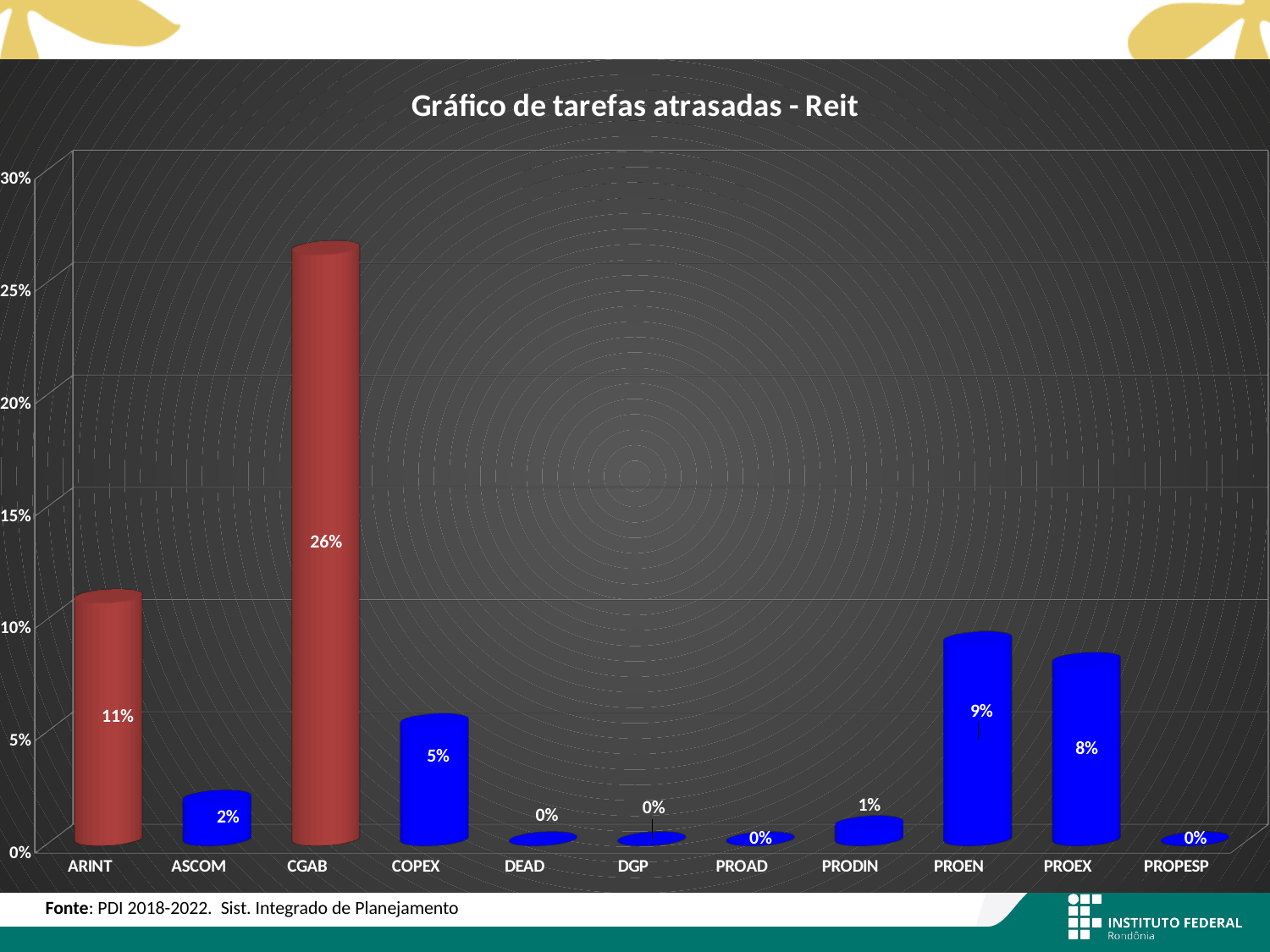
Which is larger, the value for COPEX or the value for ASCOM? COPEX What is the value for ARINT? 11% How many categories have a value of 0%? 4 What is the title of the chart? Gráfico de tarefas atrasadas - Reit Which category has the highest value? CGAB How many categories are shown on the x axis? 11 What is the value for PRODIN? 1% Is the value for CGAB greater or less than 25%? greater What is the value for CGAB? 26% What is the value for PROEN? 9% What is the difference between the values for CGAB and ARINT? 15% What is the difference between the values for PROEN and PROEX? 1%